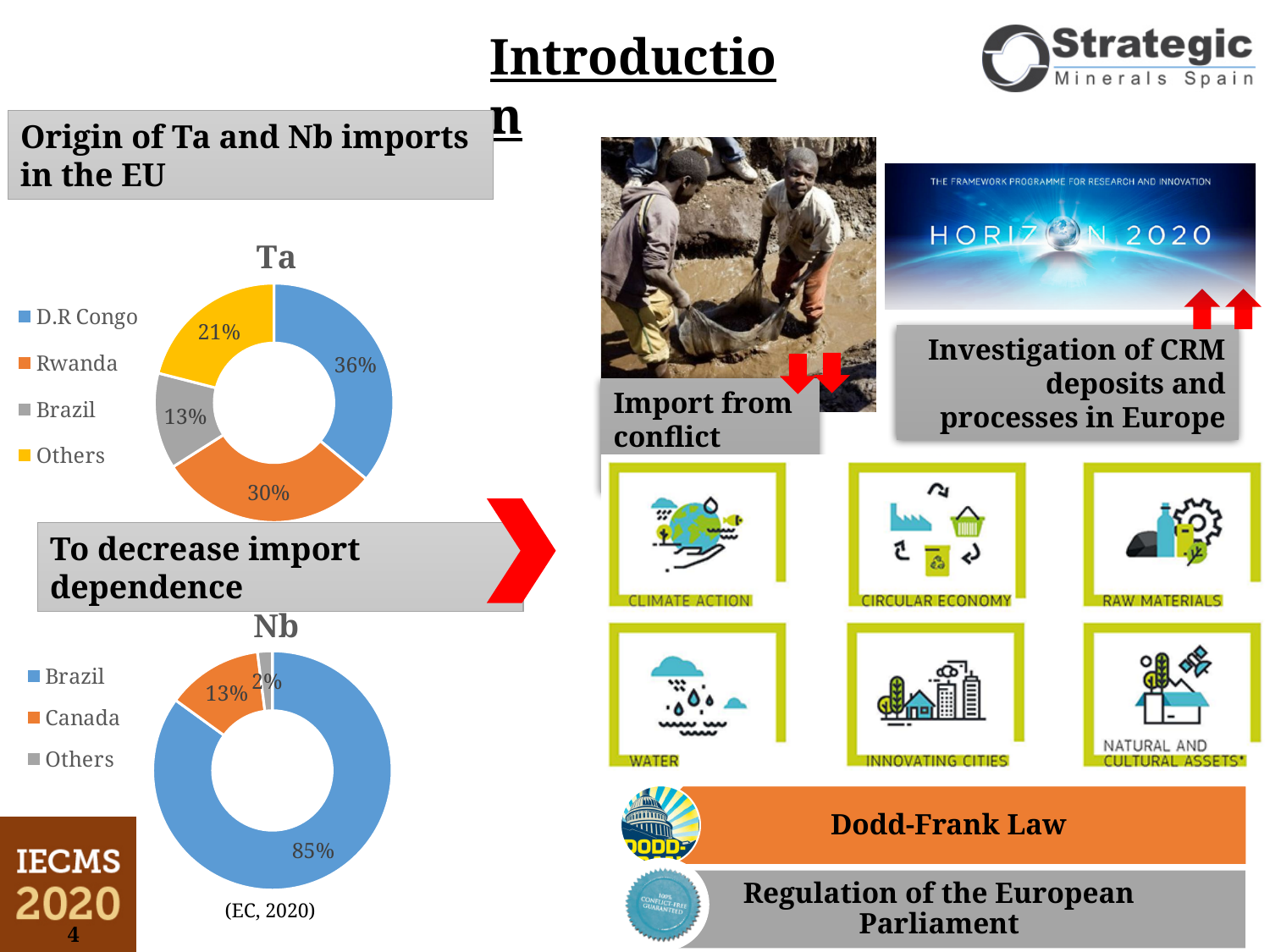
In the Ta chart, what is the difference between the shares of D.R Congo and Rwanda? 6% In the Ta chart, how many origin categories are shown in the legend? 4 In the Nb chart, what share of EU Nb imports comes from Canada? 13% What type of chart is used to show the origin of Ta imports? Doughnut (pie) chart In the Nb chart, which is larger, the share for Canada or the share for Others? Canada In the Nb chart, what share of EU Nb imports comes from Brazil? 85% In the Ta chart, what share of EU Ta imports comes from D.R Congo? 36% In the Ta chart, which origin has the smallest share? Brazil In the Ta chart, what share of EU Ta imports comes from Rwanda? 30% In the Nb chart, what share is labelled for Others? 2% In the Ta chart, which origin has the largest share? D.R Congo In the Nb chart, what is the difference between the shares of Brazil and Canada? 72%